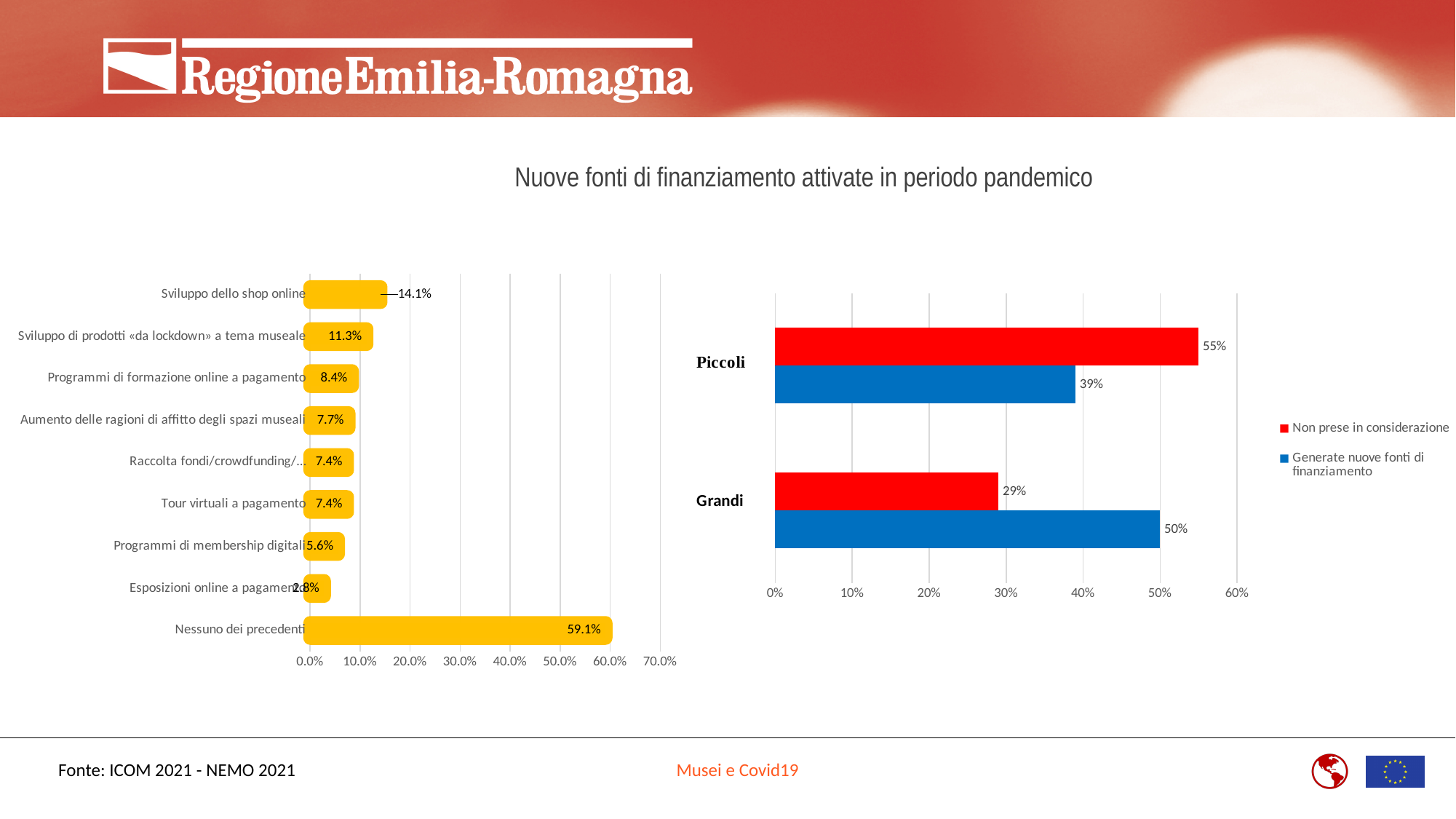
In the right chart, what is the difference between Non prese in considerazione and Generate nuove fonti di finanziamento for Piccoli? 16% In the left chart, what is the difference between Sviluppo dello shop online and Sviluppo di prodotti «da lockdown» a tema museale? 2.8% In the left chart, what is the value for Programmi di formazione online a pagamento? 8.4% In the right chart, how many series does the legend list? 2 In the right chart, what is the value of Generate nuove fonti di finanziamento for Grandi? 50% In the left chart, which is larger: Programmi di membership digitali or Aumento delle ragioni di affitto degli spazi museali? Aumento delle ragioni di affitto degli spazi museali In the right chart, what is the value of Non prese in considerazione for Piccoli? 55% In the left chart, what is the value for Sviluppo dello shop online? 14.1% In the left chart, what is the value for Nessuno dei precedenti? 59.1% In the left chart, which category has the highest value? Nessuno dei precedenti What type of chart is the right chart? Bar chart In the left chart, how many categories are shown? 9